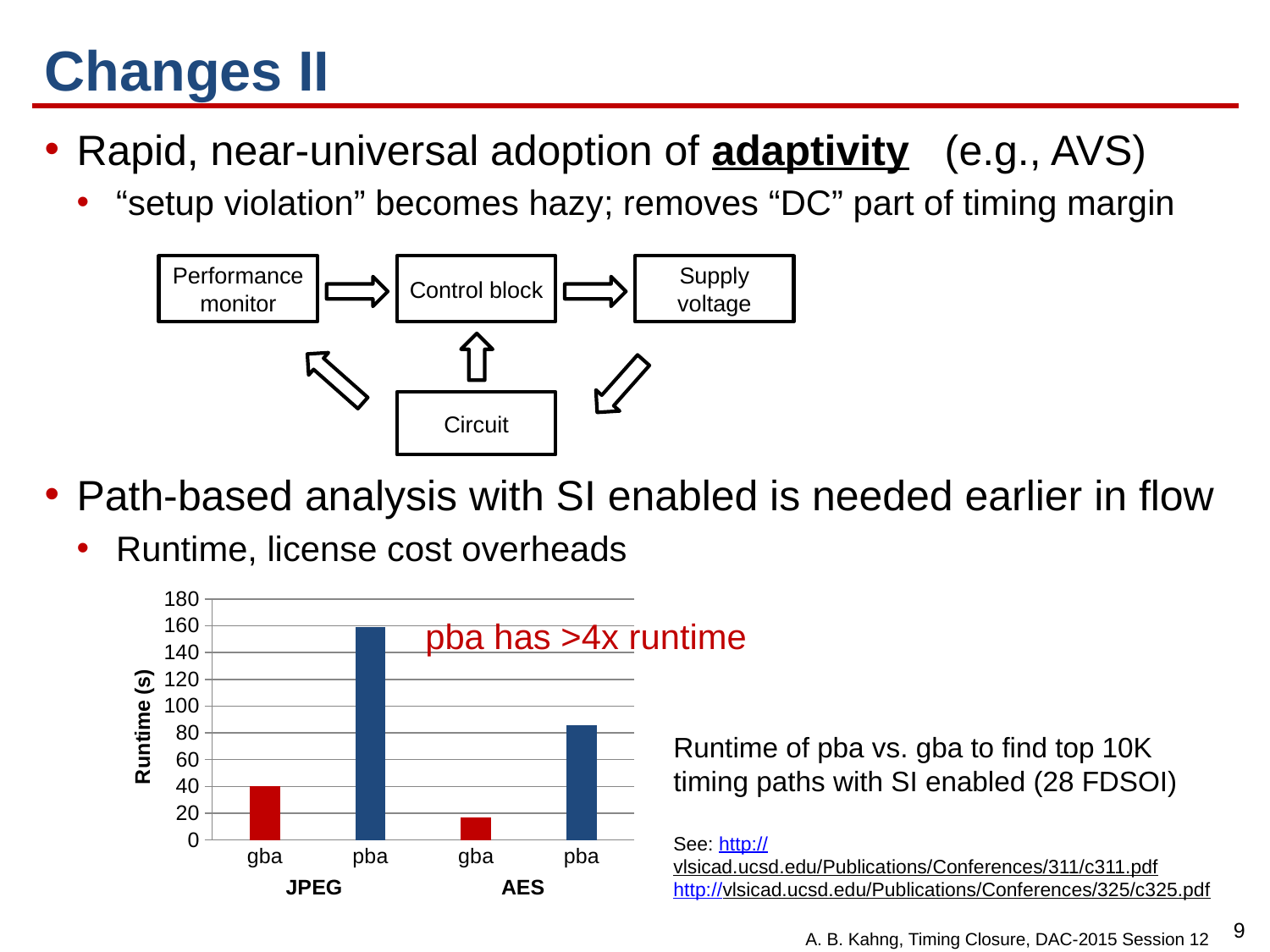
Is the runtime for AES gba greater or less than 40? less What kind of chart is shown at the bottom of the slide? bar chart In the runtime chart, which is larger: the pba runtime for JPEG or the pba runtime for AES? JPEG pba What is the label on the vertical axis of the runtime chart? Runtime (s) Which bar in the runtime chart has the lowest value? AES gba Is the runtime for JPEG pba greater or less than 140? greater Which bar in the runtime chart has the highest value? JPEG pba How many bars are plotted in the runtime chart? 4 Is the runtime for AES pba greater or less than 100? less In the runtime chart, which is larger: the gba runtime for JPEG or the gba runtime for AES? JPEG gba What annotation text is written inside the runtime chart? pba has >4x runtime